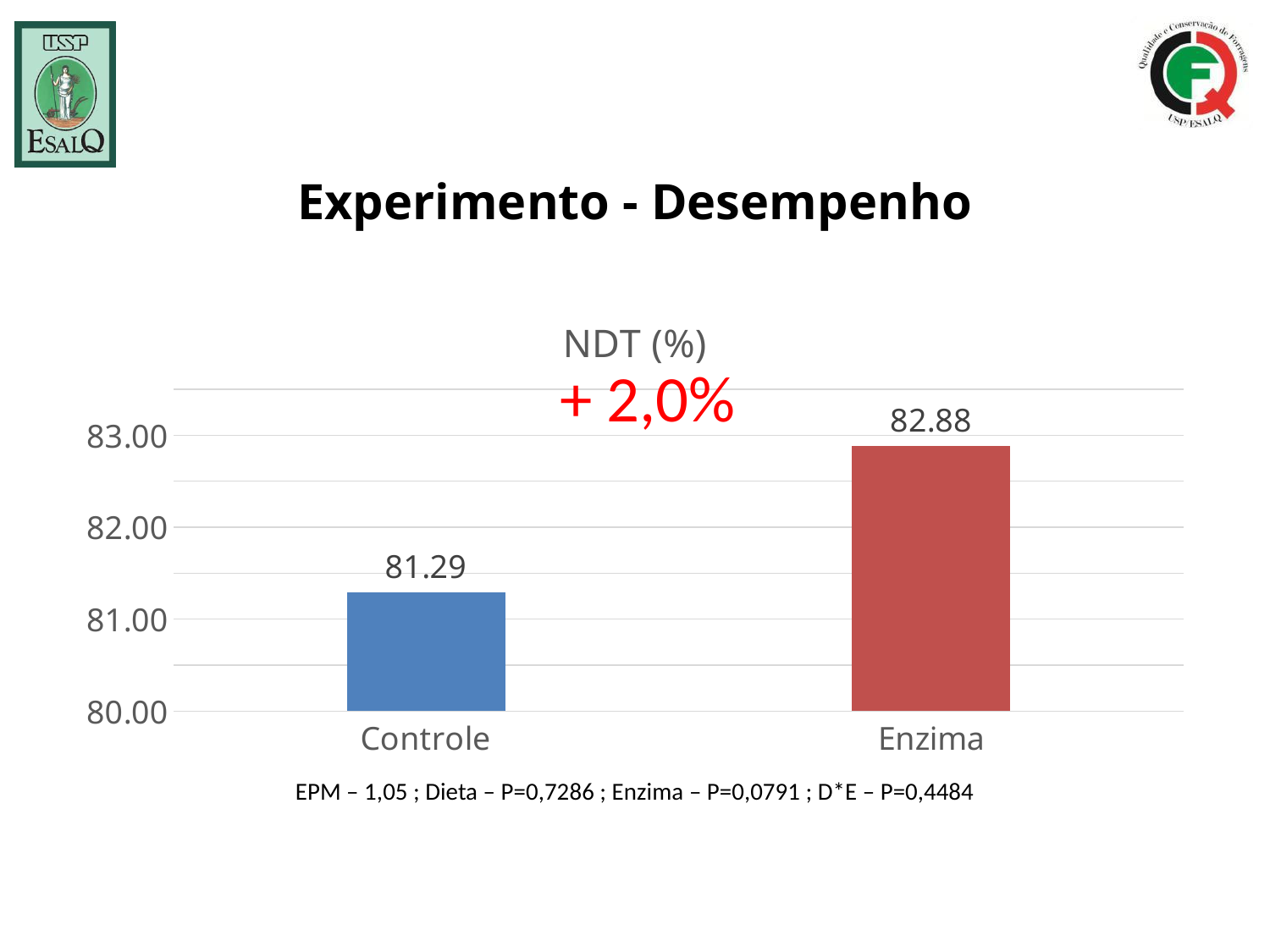
Is the value for Controle greater or less than 82.00? less Which category has the highest value? Enzima How many categories are shown in the chart? 2 Is the value for Enzima greater or less than 82.00? greater What percentage increase is annotated in red on the chart? + 2,0% What is the title of the chart? NDT (%) What is the difference between the Enzima and Controle values? 1.59 What kind of chart is shown on the slide? bar chart What is the value for Controle? 81.29 Which category has the lowest value? Controle What is the value for Enzima? 82.88 Which is larger, the value for Controle or the value for Enzima? Enzima